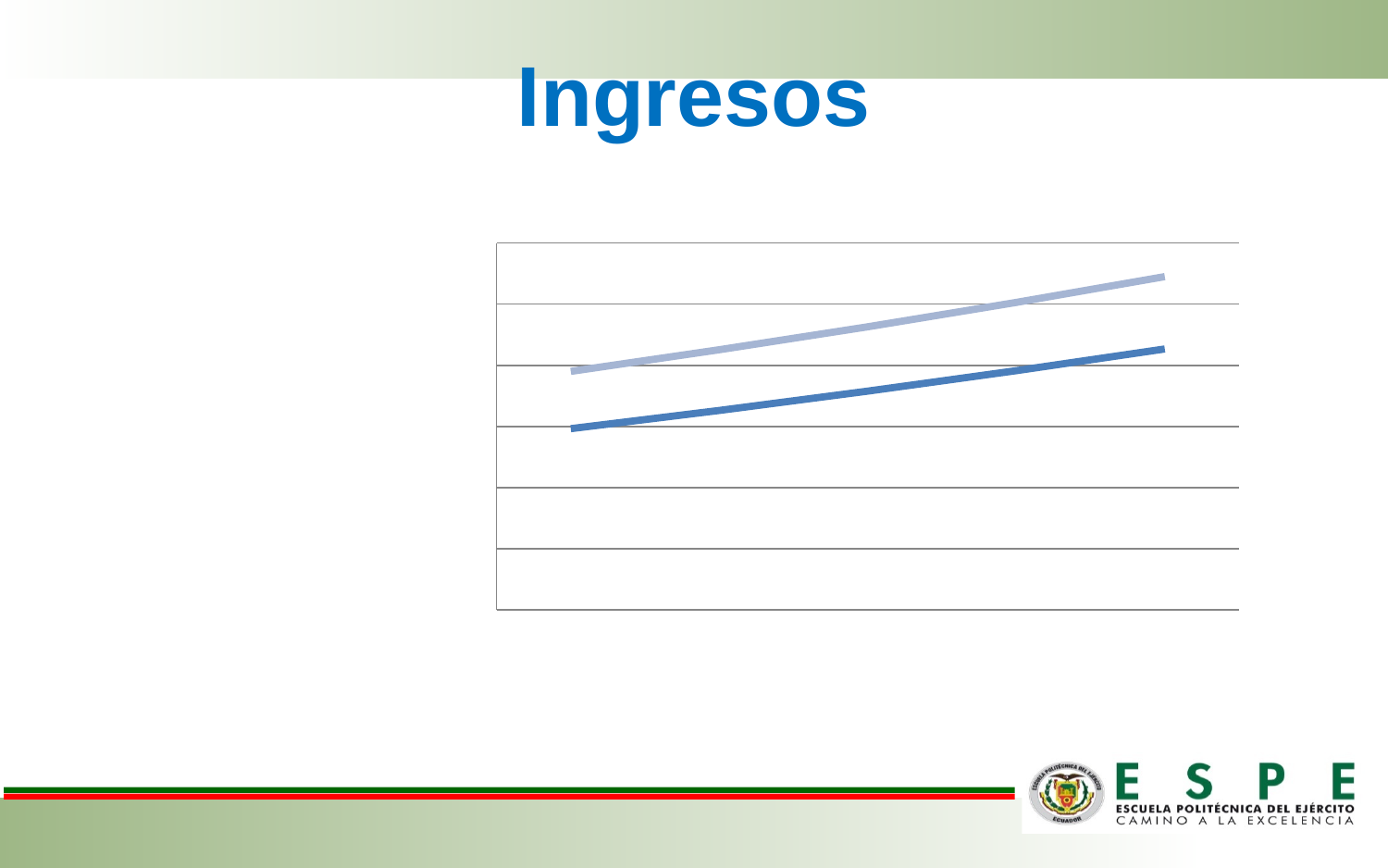
How many lines are plotted in the chart? 2 What kind of chart is shown on the slide? line chart Does the chart display a legend? No Which line is plotted higher on the chart, the light blue line or the dark blue line? the light blue line Do the lines in the chart rise or fall from left to right? rise What is the title of the slide containing the chart? Ingresos